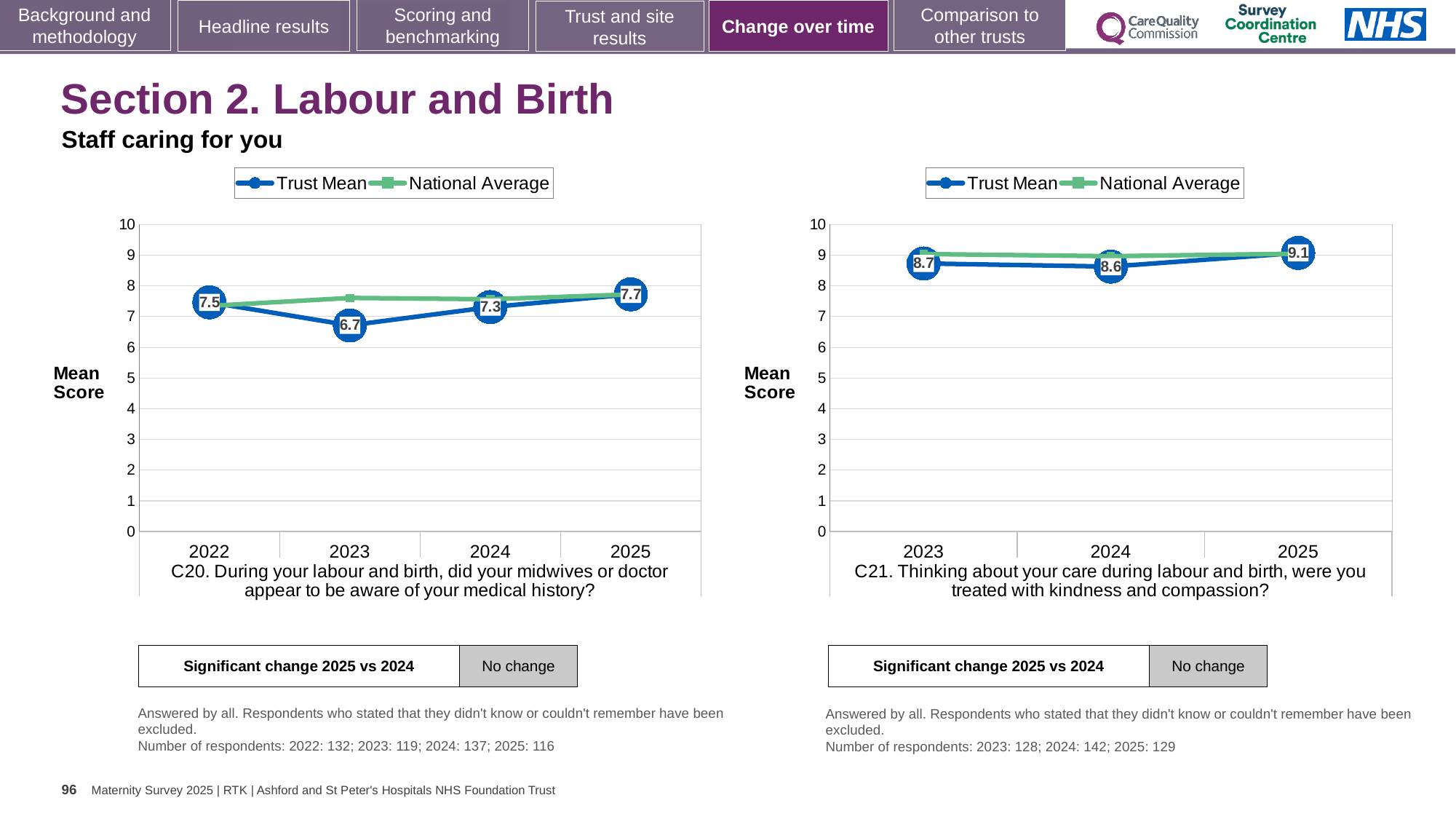
What kind of chart is the C21 chart (right)? Line chart In the C21 chart (right), which year has the highest Trust Mean score? 2025 In the C21 chart (right), what is the difference between the Trust Mean scores for 2025 and 2024? 0.5 In the C20 chart (left), which year has the highest Trust Mean score? 2025 In the C20 chart (left), what is the difference between the Trust Mean scores for 2025 and 2023? 1.0 In the C21 chart (right), how many series does the legend list? 2 In the C21 chart (right), what is the Trust Mean score for 2024? 8.6 In the C20 chart (left), how many years are plotted on the x axis? 4 In the C20 chart (left), which year has the lowest Trust Mean score? 2023 In the C20 chart (left), what is the Trust Mean score for 2025? 7.7 In the C20 chart (left), is the National Average for 2023 greater or less than 7? greater In the C20 chart (left), what is the Trust Mean score for 2023? 6.7